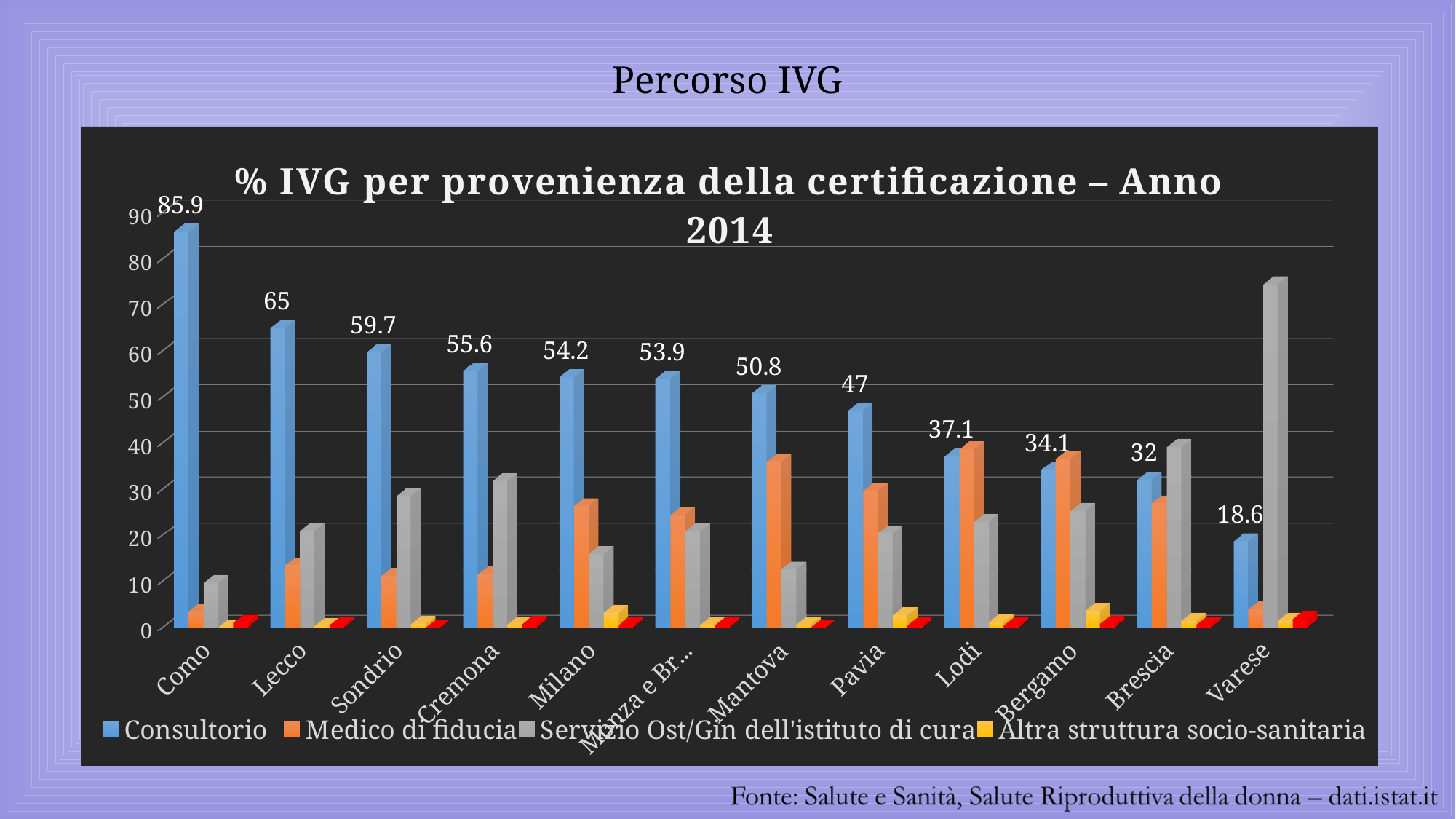
What is the difference between the Consultorio values for Como and Lecco? 20.9 Is the Servizio Ost/Gin dell'istituto di cura value for Varese greater or less than 70? greater What kind of chart is shown on the slide? bar chart Which province has the lowest Consultorio value? Varese How many series does the legend list? 4 Which has a larger Consultorio value, Sondrio or Cremona? Sondrio What is the Consultorio value for Varese? 18.6 What is the Consultorio value for Mantova? 50.8 What is the Consultorio value for Como? 85.9 Which province has the highest Consultorio value? Como Do the Consultorio values rise or fall from Como to Varese along the x axis? fall How many provinces are shown on the x axis? 12